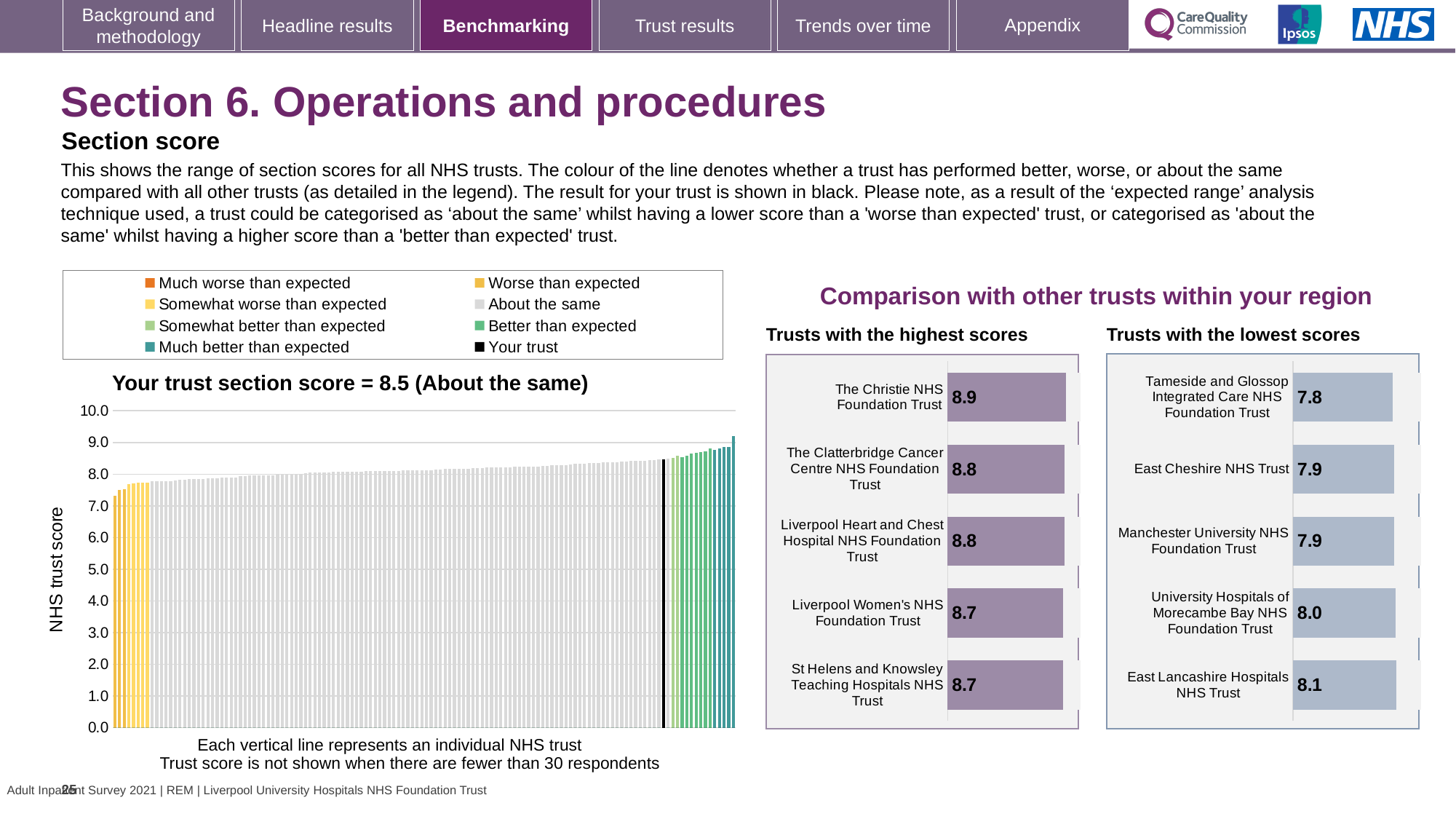
In the 'Trusts with the highest scores' chart, what is the score for Liverpool Women's NHS Foundation Trust? 8.7 In the 'Trusts with the highest scores' chart, what is the difference between the scores of The Christie NHS Foundation Trust and St Helens and Knowsley Teaching Hospitals NHS Trust? 0.2 How many entries does the legend above the 'Your trust section score' chart list? 8 In the chart titled 'Your trust section score = 8.5 (About the same)', what is the section score for your trust? 8.5 In the 'Trusts with the lowest scores' chart, which trust has the lowest score? Tameside and Glossop Integrated Care NHS Foundation Trust In the 'Trusts with the lowest scores' chart, which has the larger score: East Lancashire Hospitals NHS Trust or Tameside and Glossop Integrated Care NHS Foundation Trust? East Lancashire Hospitals NHS Trust In the 'Trusts with the highest scores' chart, which trust has the highest score? The Christie NHS Foundation Trust In the 'Trusts with the highest scores' chart, what is the score for The Christie NHS Foundation Trust? 8.9 In the 'Trusts with the lowest scores' chart, what is the score for Tameside and Glossop Integrated Care NHS Foundation Trust? 7.8 How many trusts are shown in the 'Trusts with the lowest scores' chart? 5 In the 'Trusts with the lowest scores' chart, what is the score for East Lancashire Hospitals NHS Trust? 8.1 In the chart titled 'Your trust section score = 8.5 (About the same)', do the trust scores rise or fall from left to right? rise